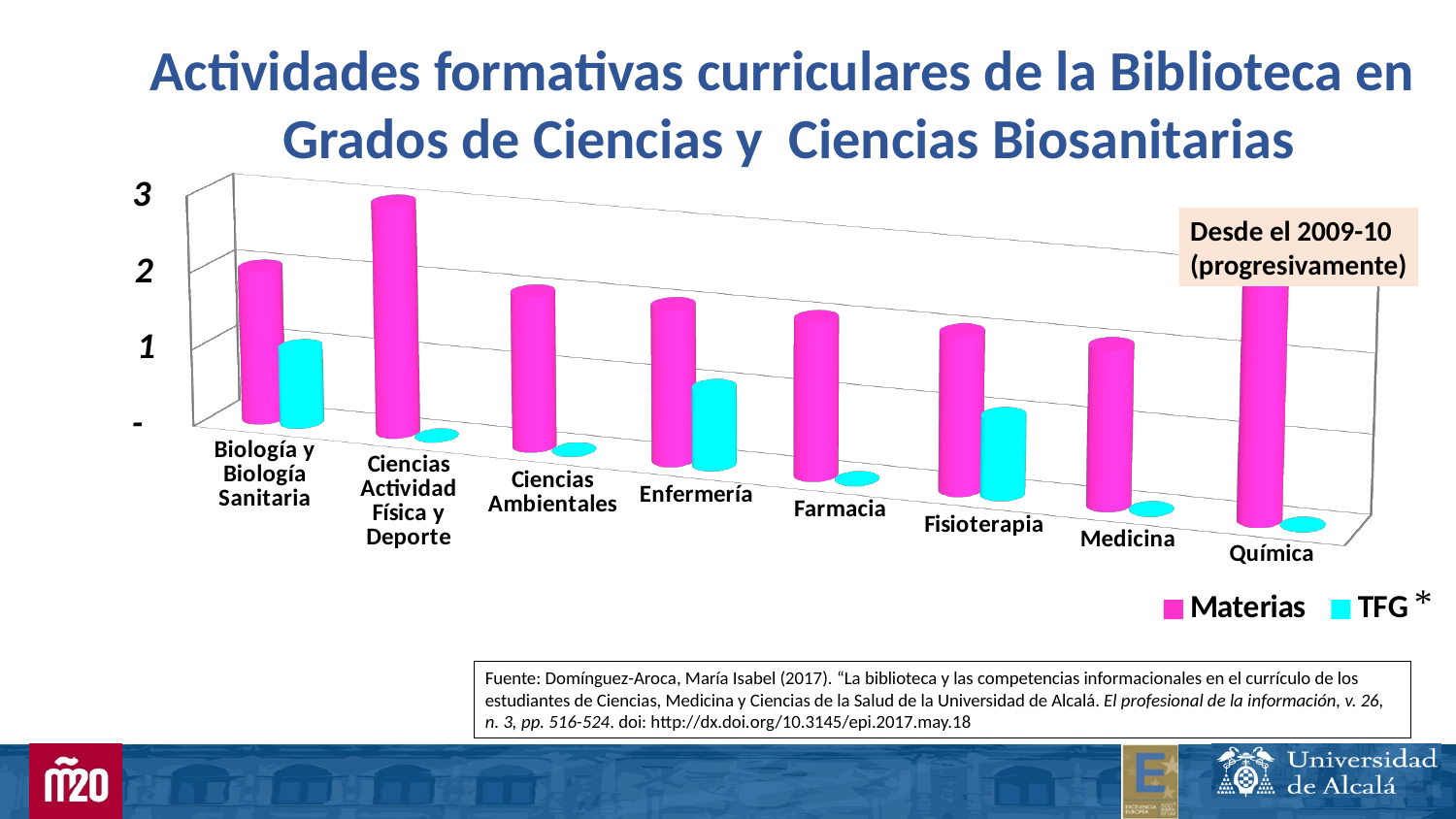
What are the two series named in the chart legend? Materias and TFG Which is larger, the TFG value for Enfermería or the TFG value for Farmacia? Enfermería How many categories show a visible (non-zero) TFG bar? 3 Is the Materias value for Ciencias Actividad Física y Deporte greater or less than 2? greater What colour are the Materias bars in the chart? magenta (pink) How many degree programmes (categories) are shown on the x axis of the chart? 8 Which is larger, the Materias value for Ciencias Actividad Física y Deporte or the Materias value for Medicina? Ciencias Actividad Física y Deporte How many series does the chart legend list? 2 For Biología y Biología Sanitaria, which series has the larger value, Materias or TFG? Materias Is the TFG value for Farmacia greater or less than 1? less Is the Materias value for Medicina greater or less than 3? less What kind of chart is shown on the slide? bar chart